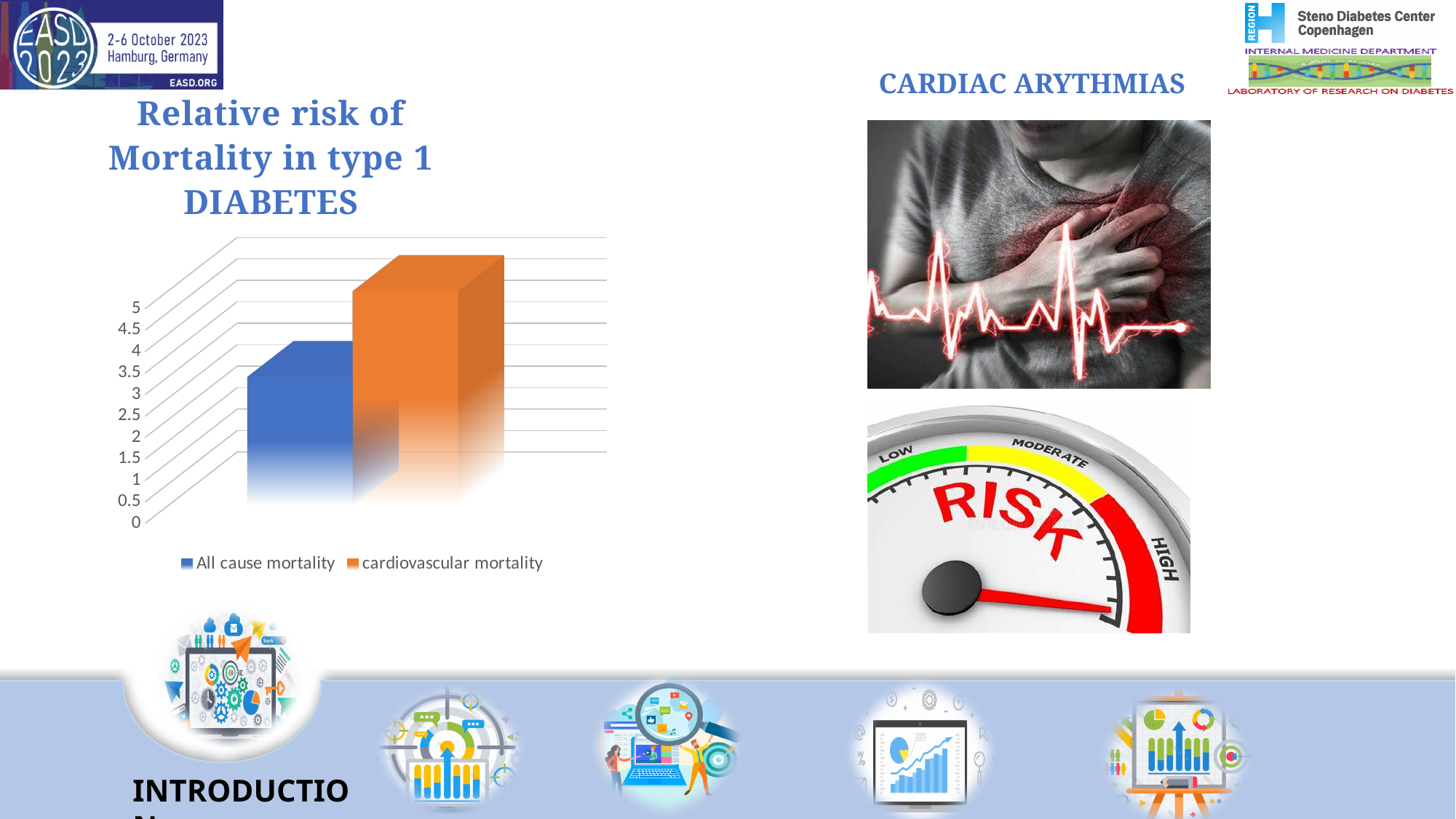
What kind of chart is shown on the slide? bar chart How many series does the chart legend list? 2 Which series shows the highest relative risk in the chart? cardiovascular mortality Which series has the taller bar, All cause mortality or cardiovascular mortality? cardiovascular mortality Which series shows the lowest relative risk in the chart? All cause mortality What are the two series named in the chart legend? All cause mortality and cardiovascular mortality Is the value for All cause mortality greater or less than 2? greater Is the value for cardiovascular mortality greater or less than 3? greater How many bars are plotted in the chart? 2 What is the highest value shown on the chart's vertical axis? 5 What is the title of the chart? Relative risk of Mortality in type 1 DIABETES